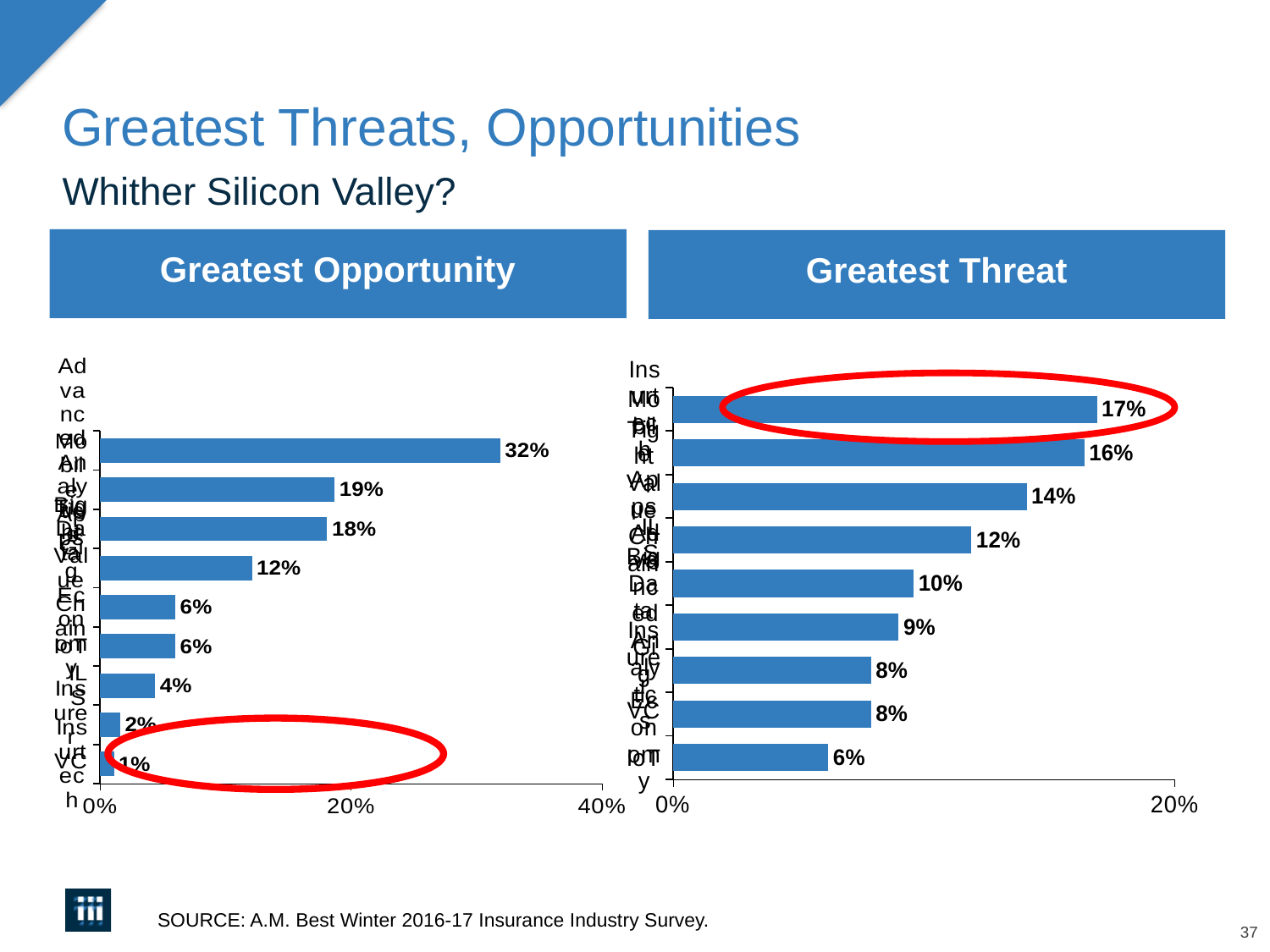
In the Greatest Threat chart, what is the highest value shown? 17% In the Greatest Threat chart, what is the difference between the top bar and the second bar? 1% How many bars are plotted in the Greatest Threat chart? 9 In the Greatest Threat chart, what value is labelled on the bar circled in red? 17% How many bars are plotted in the Greatest Opportunity chart? 9 Which chart has the larger top value, Greatest Opportunity or Greatest Threat? Greatest Opportunity In the Greatest Opportunity chart, what is the difference between the largest bar and the smallest bar? 31% What kind of chart is the Greatest Opportunity chart? bar chart In the Greatest Opportunity chart, what is the lowest value shown? 1% In the Greatest Opportunity chart, what is the highest value shown? 32% What is the maximum value shown on the x axis of the Greatest Opportunity chart? 40% In the Greatest Threat chart, what is the lowest value shown? 6%